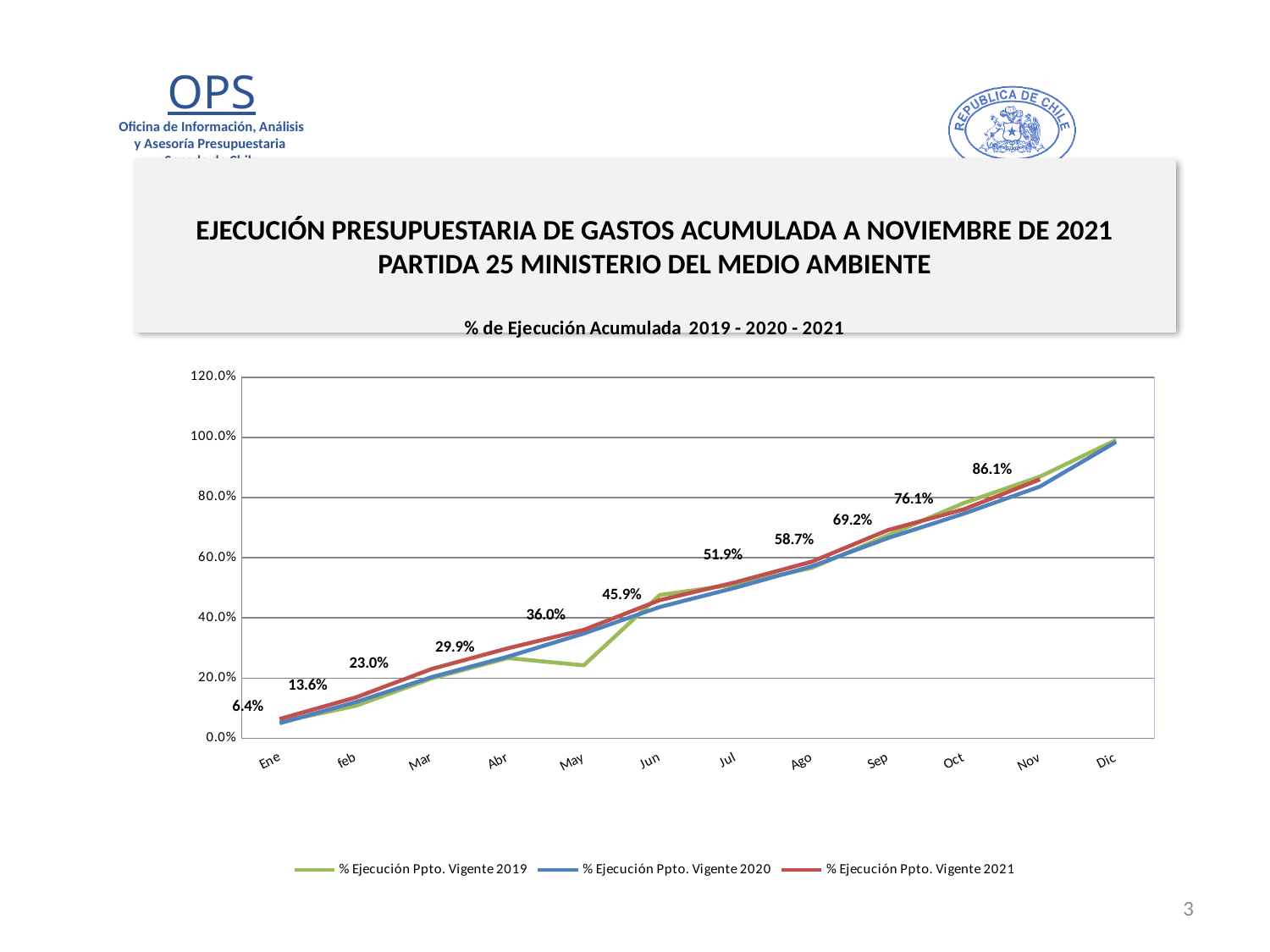
What is the value of % Ejecución Ppto. Vigente 2021 in Jun? 45.9% Which month has the highest labelled value for % Ejecución Ppto. Vigente 2021? Nov Which month has the lowest labelled value for % Ejecución Ppto. Vigente 2021? Ene What is the value of % Ejecución Ppto. Vigente 2021 in Ene? 6.4% How many series does the legend list? 3 What is the title of the chart? % de Ejecución Acumulada 2019 - 2020 - 2021 What kind of chart is shown on the slide? line chart How many months are shown along the x axis? 12 Do the values of % Ejecución Ppto. Vigente 2021 rise or fall from Ene to Nov? rise What is the difference in percentage points between the 2021 values for Nov and Oct? 10.0 Is the value for % Ejecución Ppto. Vigente 2019 in May greater or less than 40.0%? less What is the value of % Ejecución Ppto. Vigente 2021 in Nov? 86.1%